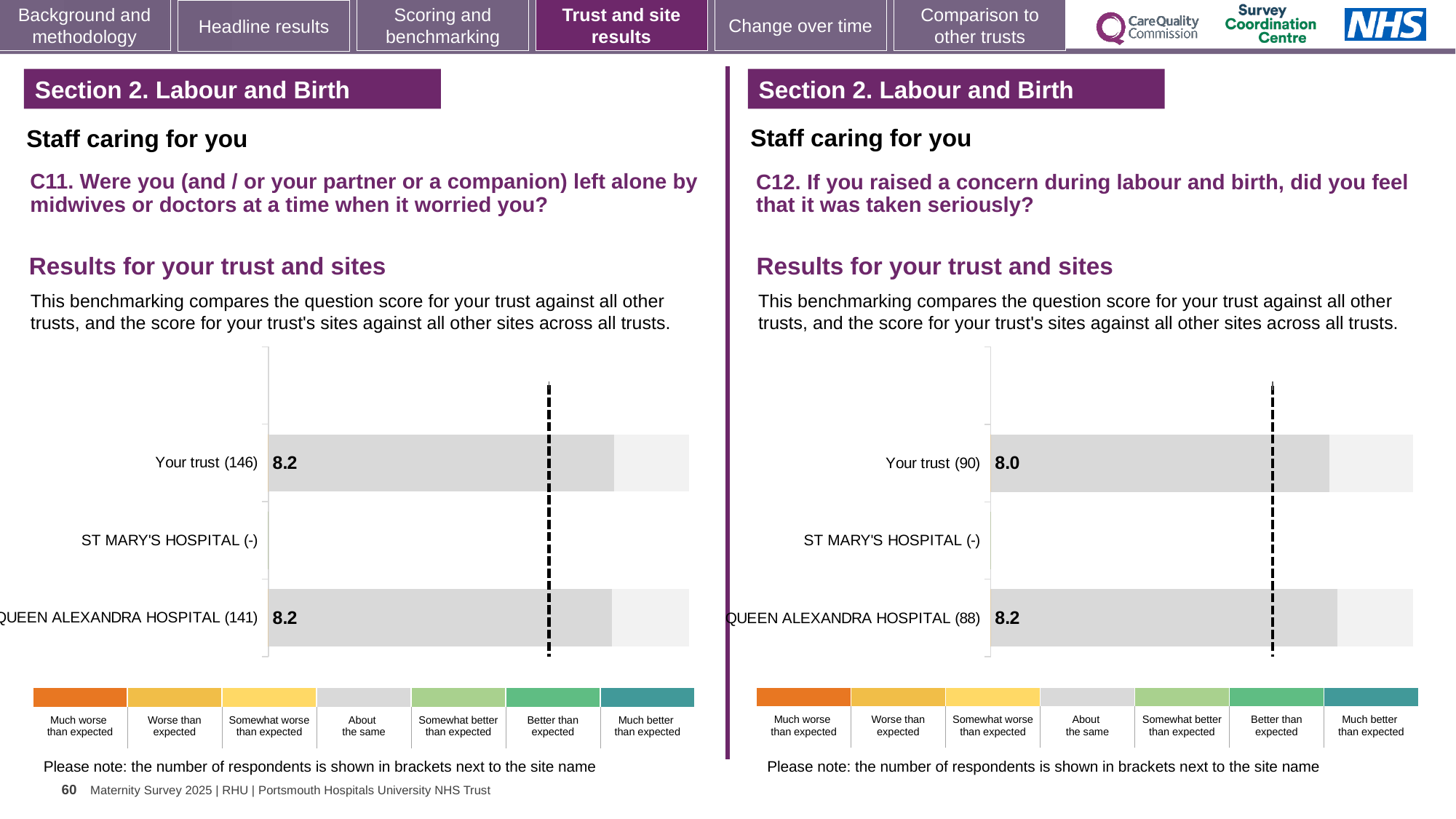
How many categories does the colour key below the C12 chart (right) list, from 'Much worse than expected' to 'Much better than expected'? 7 On the C11 chart (left), what is the score for Your trust? 8.2 On the C12 chart (right), what is the difference between the Queen Alexandra Hospital score and the Your trust score? 0.2 On the C11 chart (left), how many respondents are shown in brackets for Your trust? 146 On the C12 chart (right), which is higher: the score for Your trust or for Queen Alexandra Hospital? Queen Alexandra Hospital On the C12 chart (right), how many respondents are shown in brackets for Queen Alexandra Hospital? 88 How many categories (rows) are listed on the C11 chart (left)? 3 On the C12 chart (right), what is the score for Your trust? 8.0 On the C11 chart (left), which site has no score shown? St Mary's Hospital On the C12 chart (right), what is the score for Queen Alexandra Hospital? 8.2 What kind of chart is used on the C12 chart (right)? Bar chart On the C11 chart (left), what is the score for Queen Alexandra Hospital? 8.2